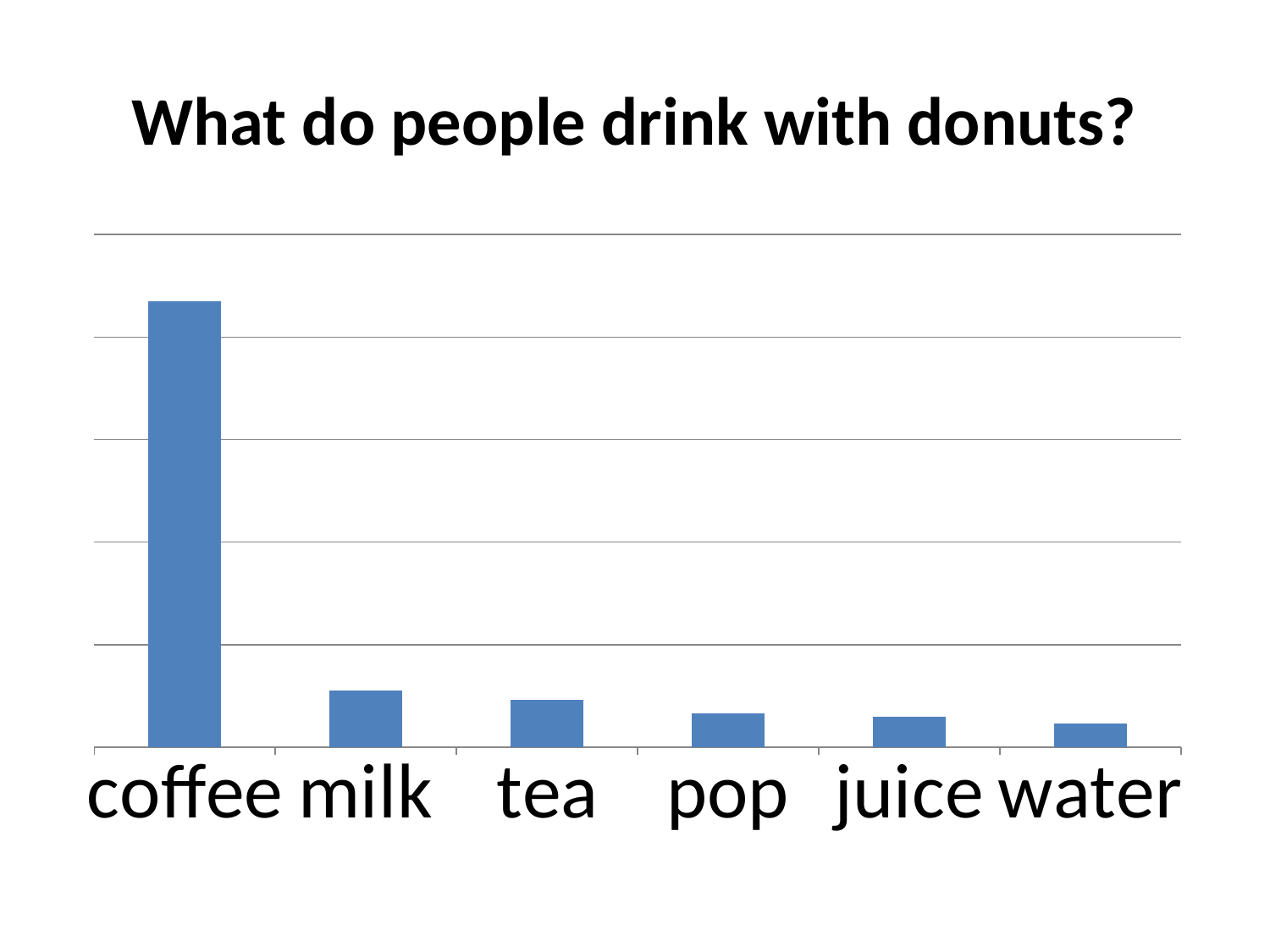
Which drink is listed first on the x axis? coffee Which is larger, the value for tea or the value for water? tea What is the title of the chart? What do people drink with donuts? How many drink categories are shown on the x axis? 6 Which is larger, the value for coffee or the value for milk? coffee Which is larger, the value for milk or the value for water? milk Which drink has the highest bar? coffee What kind of chart is shown on the slide? bar chart Do the bar values rise or fall from left to right along the x axis? fall